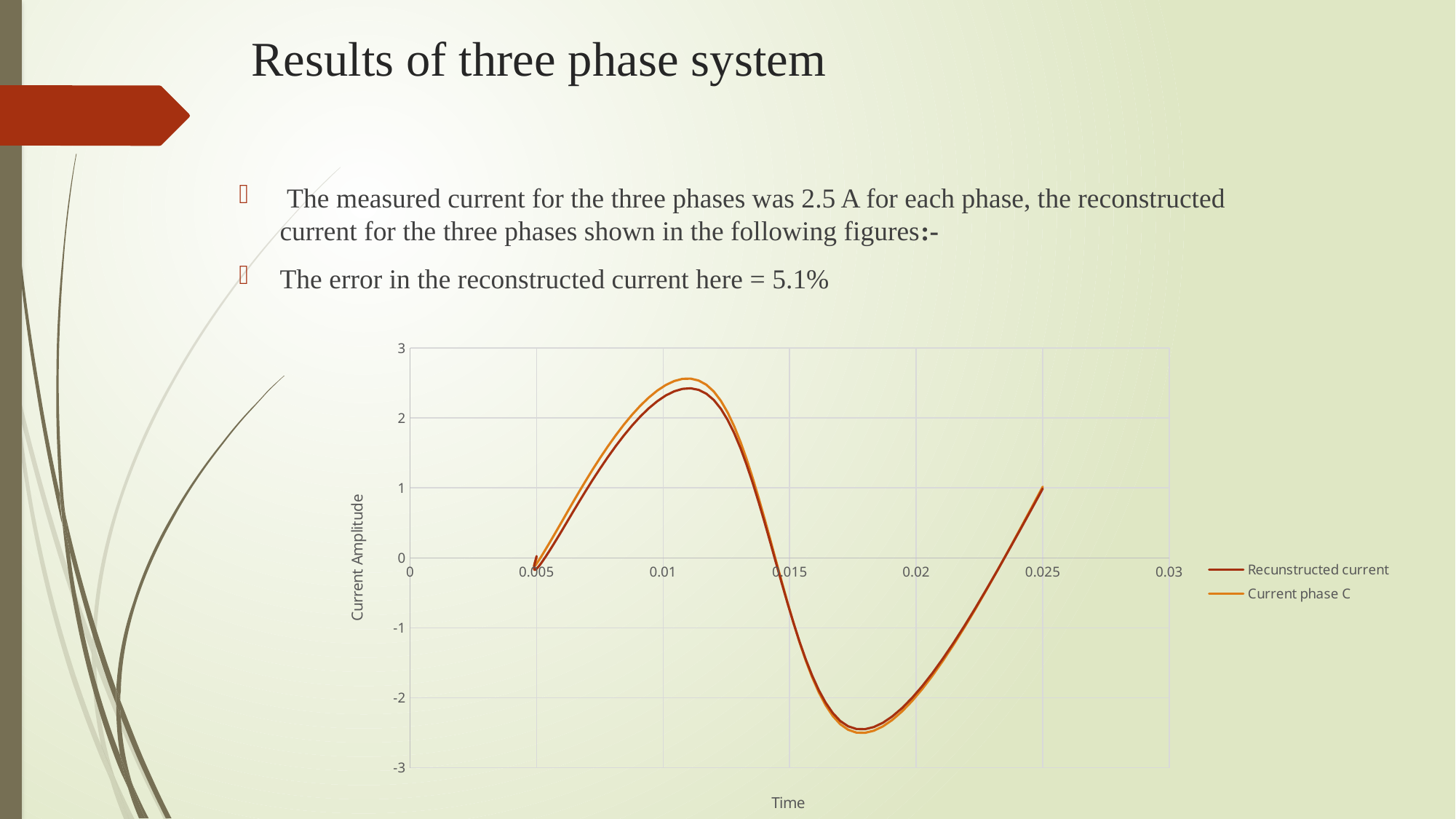
Is the peak value of the Current phase C series greater or less than 2? greater What kind of chart is shown on the slide? line chart What is the title of the vertical axis of the chart? Current Amplitude What are the two series named in the chart legend? Recunstructed current and Current phase C Is the minimum value of the Current phase C series greater or less than -2? less Is the value of the Current phase C series at time 0.02 greater or less than -1? less Between time 0.02 and time 0.025, do the plotted values rise or fall? rise How many series does the chart legend list? 2